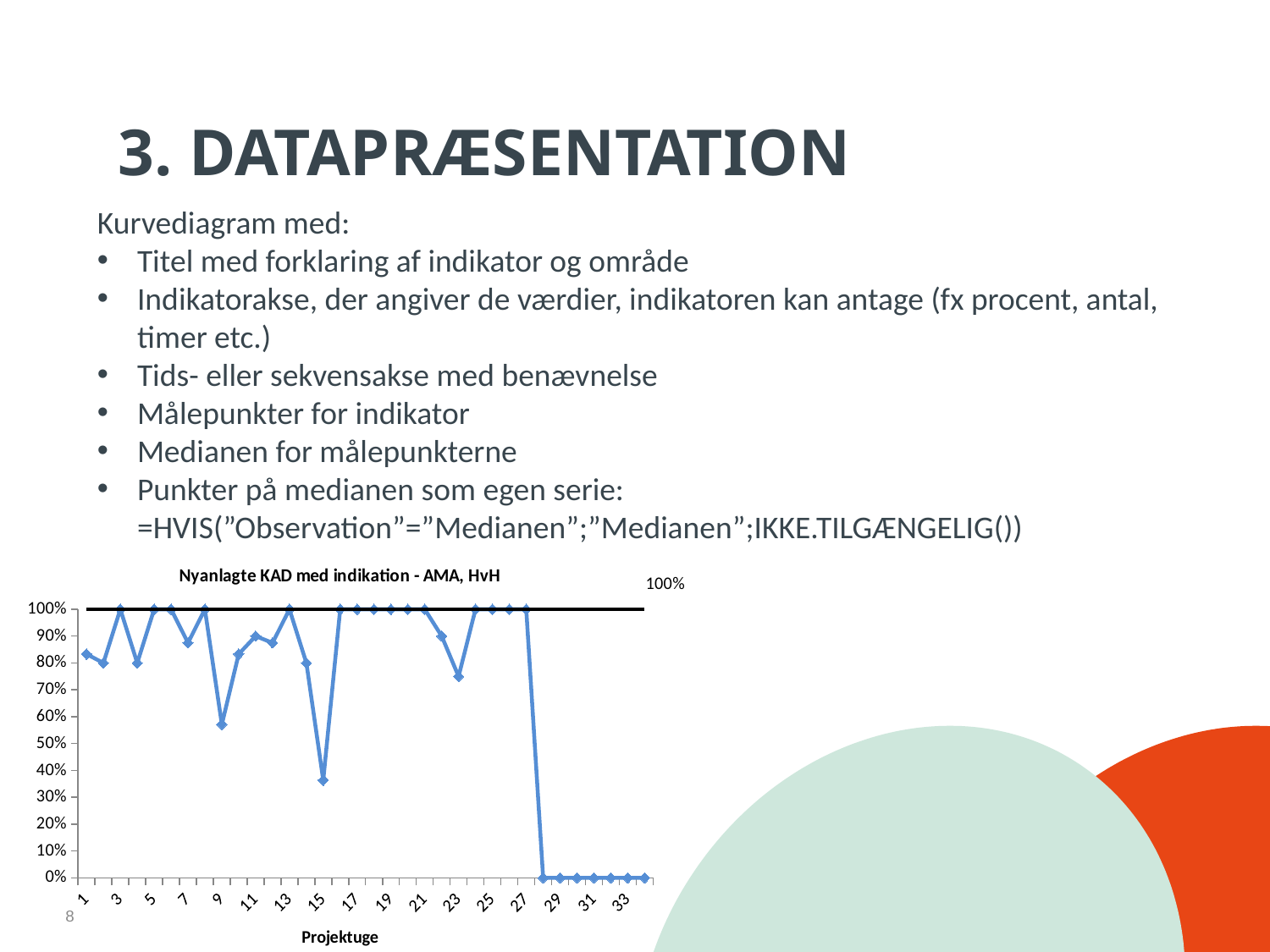
What is the title of the chart? Nyanlagte KAD med indikation - AMA, HvH Is the value for projektuge 15 greater or less than 50%? less Is the value for projektuge 13 greater or less than 90%? greater Do the values rise or fall between projektuge 27 and projektuge 28? fall What kind of chart is shown on the slide? line chart Which is larger, the value for projektuge 9 or the value for projektuge 15? projektuge 9 Is the value for projektuge 9 greater or less than 70%? less What value is printed next to the horizontal median line in the chart? 100% Among projektuge 1 to 27, which week has the lowest value? 15 What is the value for projektuge 3 in the chart? 100% What is the label of the x axis of the chart? Projektuge What is the value for projektuge 30 in the chart? 0%